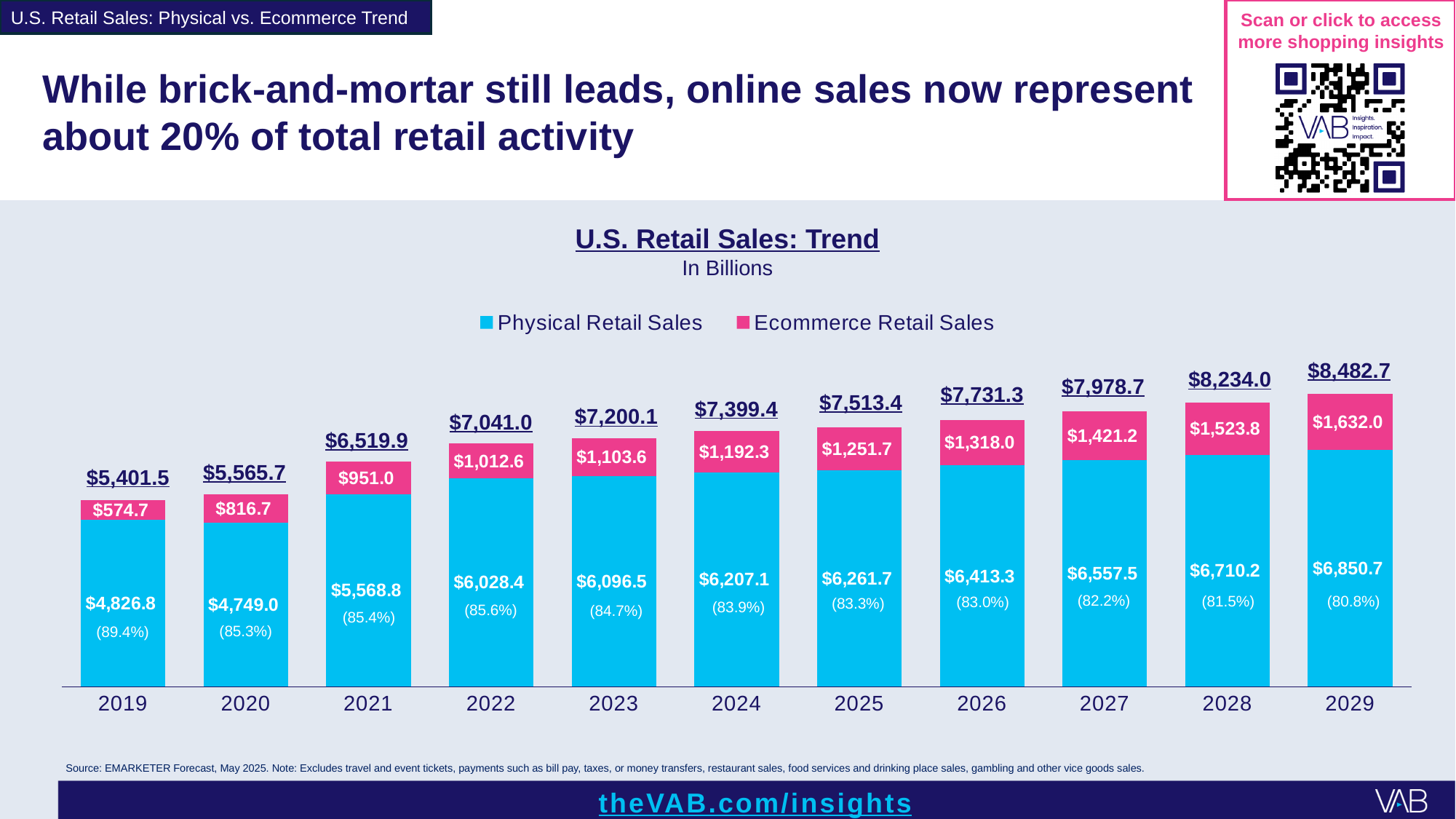
Which is larger, Physical Retail Sales in 2019 or in 2020? 2019 Which year has the highest total retail sales? 2029 How many years are shown on the x axis? 11 What share of total retail sales does Physical Retail Sales represent in 2025? 83.3% What kind of chart is shown on the slide? Stacked bar chart Do total retail sales rise or fall from 2021 to 2029? Rise Which year has the lowest Ecommerce Retail Sales value? 2019 What is the value of Ecommerce Retail Sales in 2024? $1,192.3 How many series does the legend list? 2 What is the difference between Ecommerce Retail Sales in 2029 and in 2019? $1,057.3 What is the total retail sales figure shown for 2027? $7,978.7 What is the value of Physical Retail Sales in 2021? $5,568.8